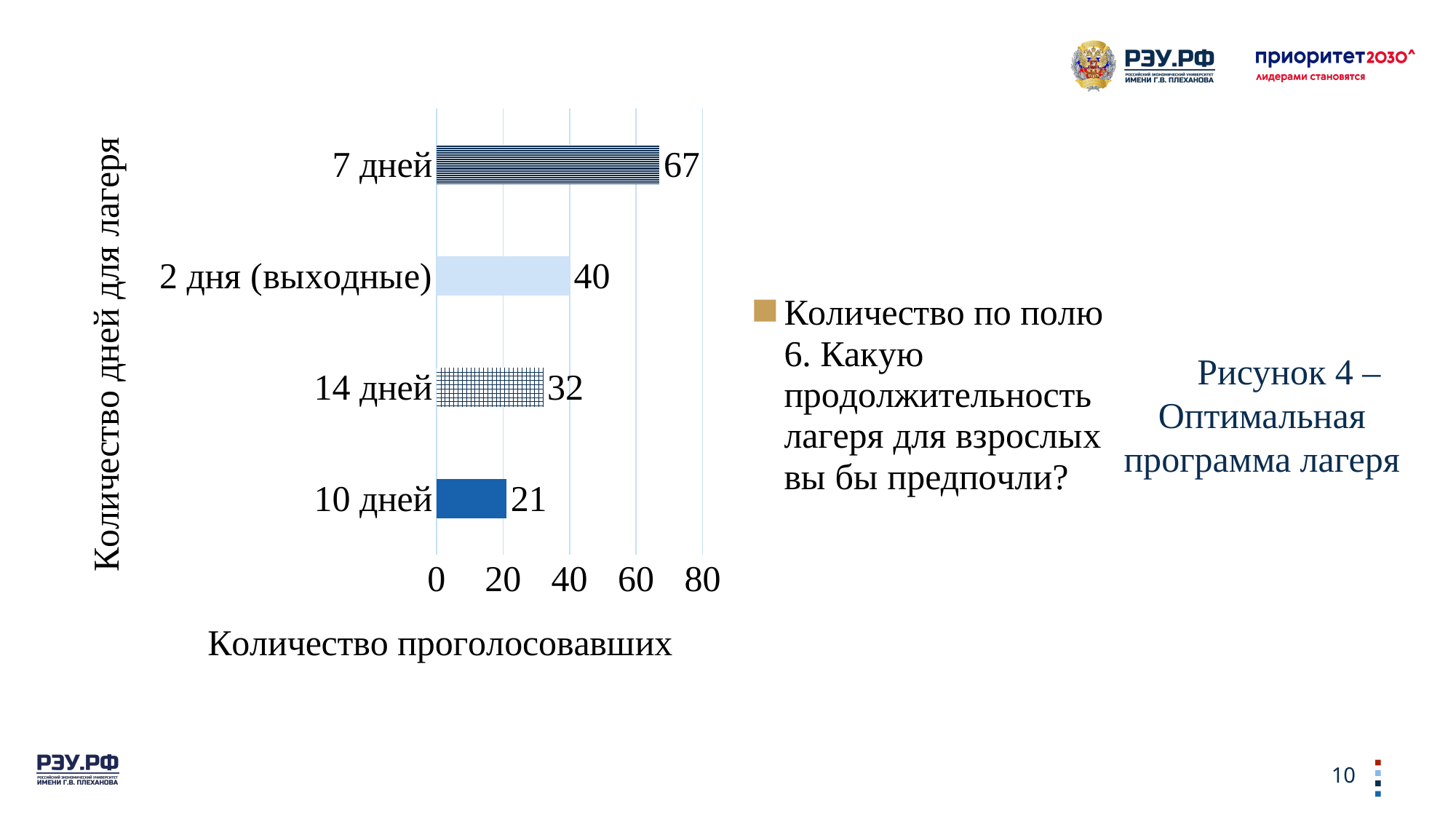
What kind of chart is shown on the slide? bar chart What is the difference between the values for "7 дней" and "2 дня (выходные)"? 27 Which category has the lowest value? 10 дней Is the value for "7 дней" greater or less than 60? greater What is the label of the x axis? Количество проголосовавших What is the value for "2 дня (выходные)"? 40 Which is larger, the value for "14 дней" or the value for "10 дней"? 14 дней What is the value for "7 дней"? 67 What is the value for "14 дней"? 32 Which category has the highest value? 7 дней How many categories are shown in the chart? 4 What is the value for "10 дней"? 21